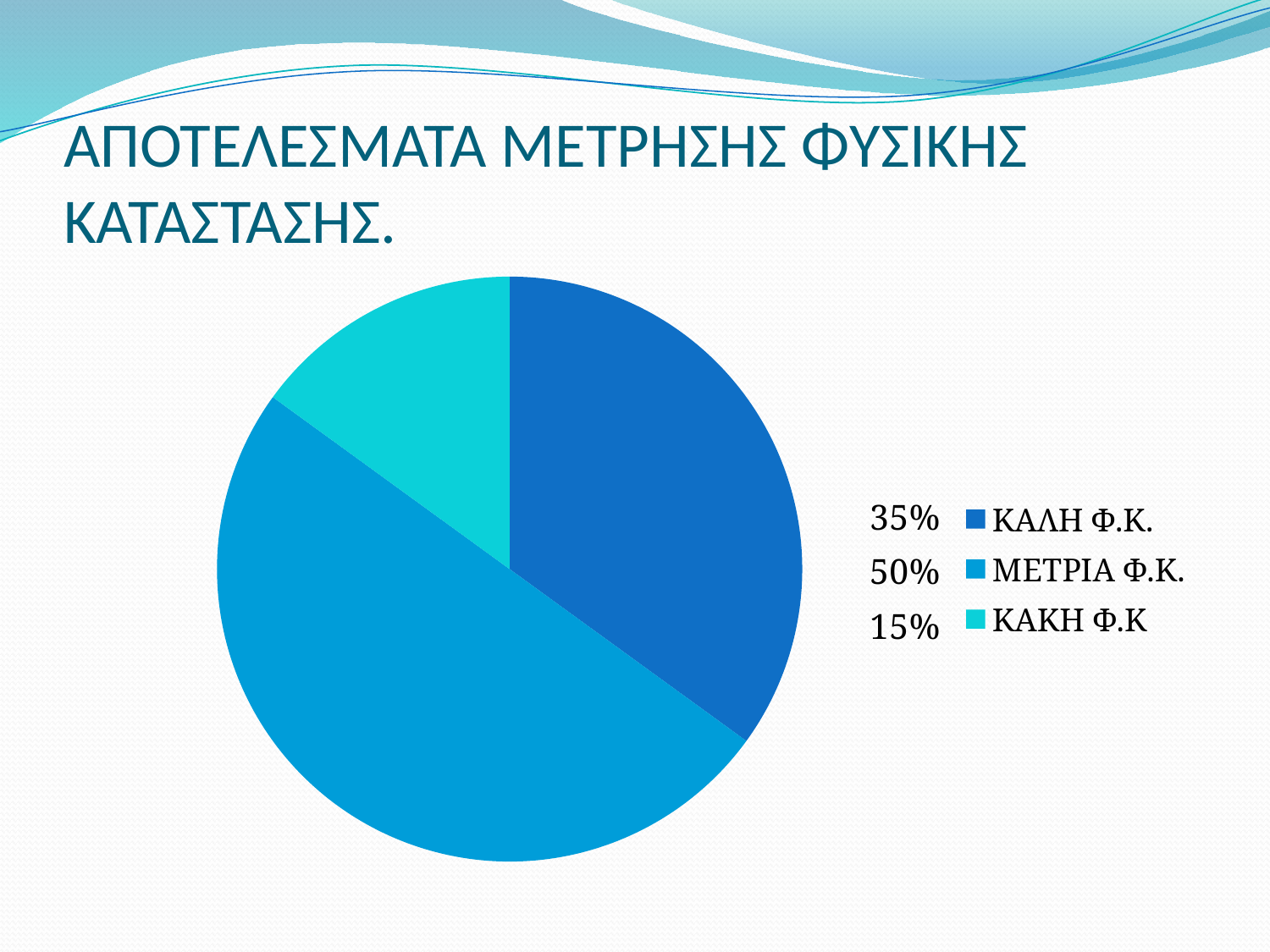
Which category has the smallest slice of the pie? ΚΑΚΗ Φ.Κ How many categories does the pie chart have? 3 Which is larger, the share for ΚΑΛΗ Φ.Κ. or the share for ΚΑΚΗ Φ.Κ? ΚΑΛΗ Φ.Κ. What share of the pie does ΚΑΚΗ Φ.Κ represent? 15% Which category has the largest slice of the pie? ΜΕΤΡΙΑ Φ.Κ. What is the title of the slide containing the pie chart? ΑΠΟΤΕΛΕΣΜΑΤΑ ΜΕΤΡΗΣΗΣ ΦΥΣΙΚΗΣ ΚΑΤΑΣΤΑΣΗΣ. Which category is shown in the lightest (turquoise) colour in the legend? ΚΑΚΗ Φ.Κ What kind of chart is shown on the slide? pie chart What share of the pie does ΚΑΛΗ Φ.Κ. represent? 35% What share of the pie does ΜΕΤΡΙΑ Φ.Κ. represent? 50% What is the difference in percentage points between ΜΕΤΡΙΑ Φ.Κ. and ΚΑΛΗ Φ.Κ.? 15% What is the difference in percentage points between ΚΑΛΗ Φ.Κ. and ΚΑΚΗ Φ.Κ? 20%